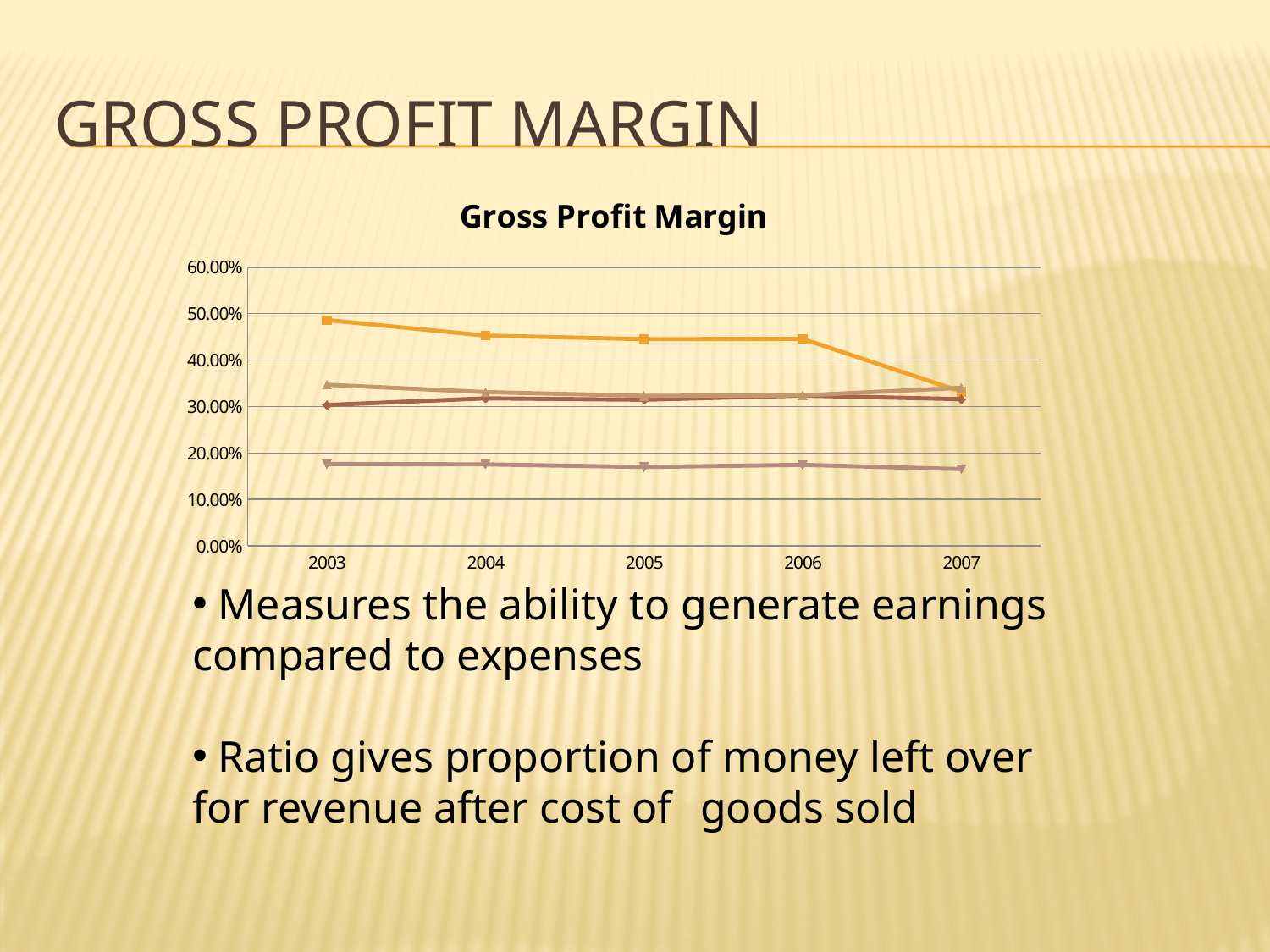
How many years are shown on the x axis of the chart? 5 In which year does the orange line with square markers reach its highest value? 2003 In which year does the orange line with square markers reach its lowest value? 2007 What is the highest value shown on the y axis of the chart? 60.00% What kind of chart is shown on the slide? line chart What is the title of the chart? Gross Profit Margin Is the value of the line with triangle markers in 2003 greater or less than 30.00%? greater Is the value of the orange line with square markers in 2003 greater or less than 40.00%? greater Is the value of the orange line with square markers in 2007 greater or less than 40.00%? less Does the orange line with square markers rise or fall from 2003 to 2007? fall How many lines are plotted on the chart? 4